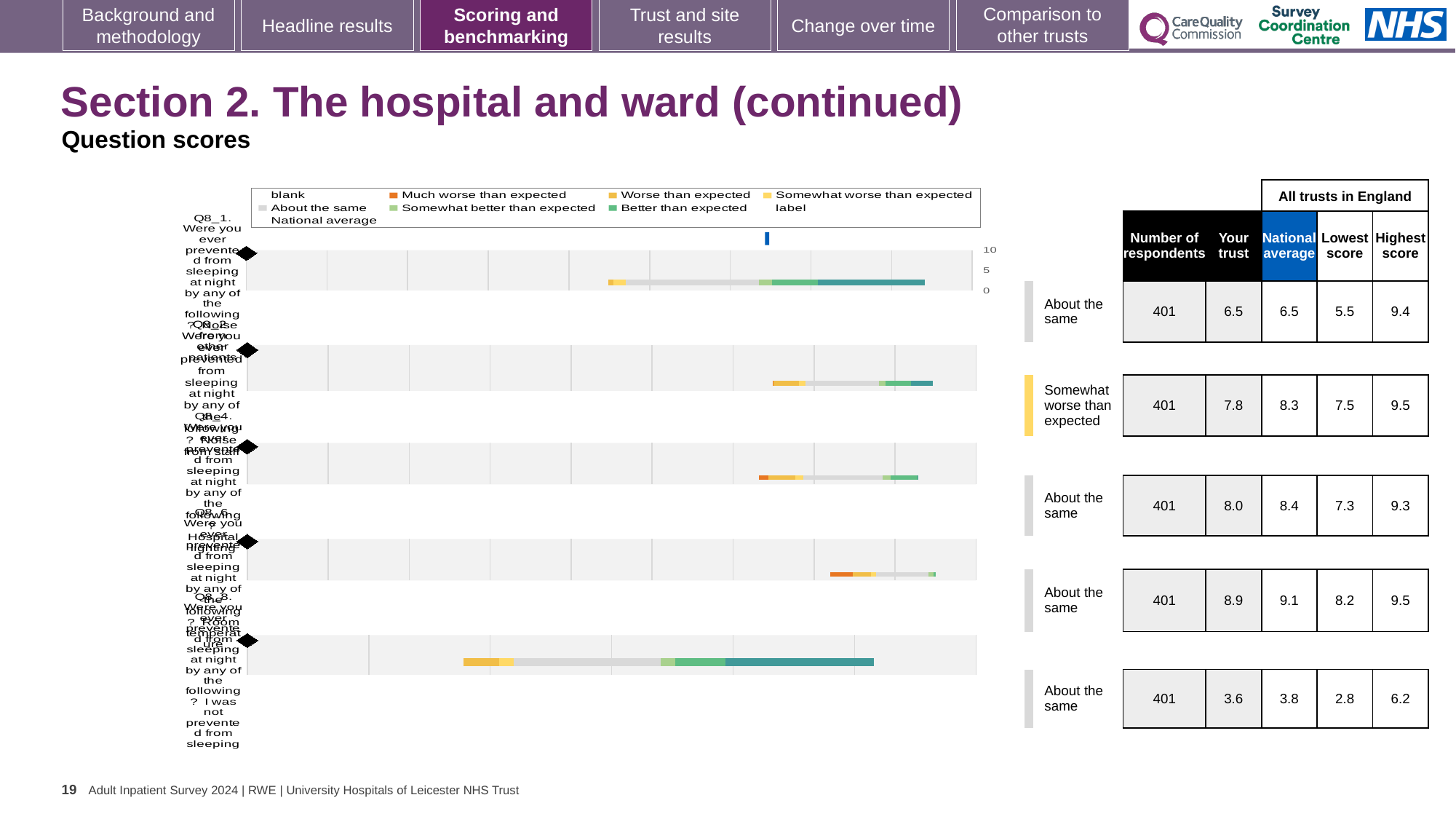
In the table beside the chart, what is the 'Your trust' score for the first row (Q8_1)? 6.5 What is the maximum value shown on the chart's axis? 10 What kind of chart is shown on the slide? bar chart In the table beside the chart, what is the national average for the second row (Q8_2)? 8.3 In the table beside the chart, which row has the highest 'Your trust' score? Q8_6 (8.9) How many horizontal bars are plotted in the chart? 5 In the table beside the chart, which row has the lowest 'Your trust' score? Q8_8 (3.6) Which legend entry is shown in dark orange? Much worse than expected In the table beside the chart, what is the 'Your trust' score for the last row (Q8_8)? 3.6 In the table beside the chart, how many respondents are listed for each question? 401 In the table beside the chart, what is the difference between the national average and 'Your trust' score for the second row (Q8_2)? 0.5 In the table beside the chart, is the 'Your trust' score for the third row (Q8_4) larger or smaller than the national average? smaller